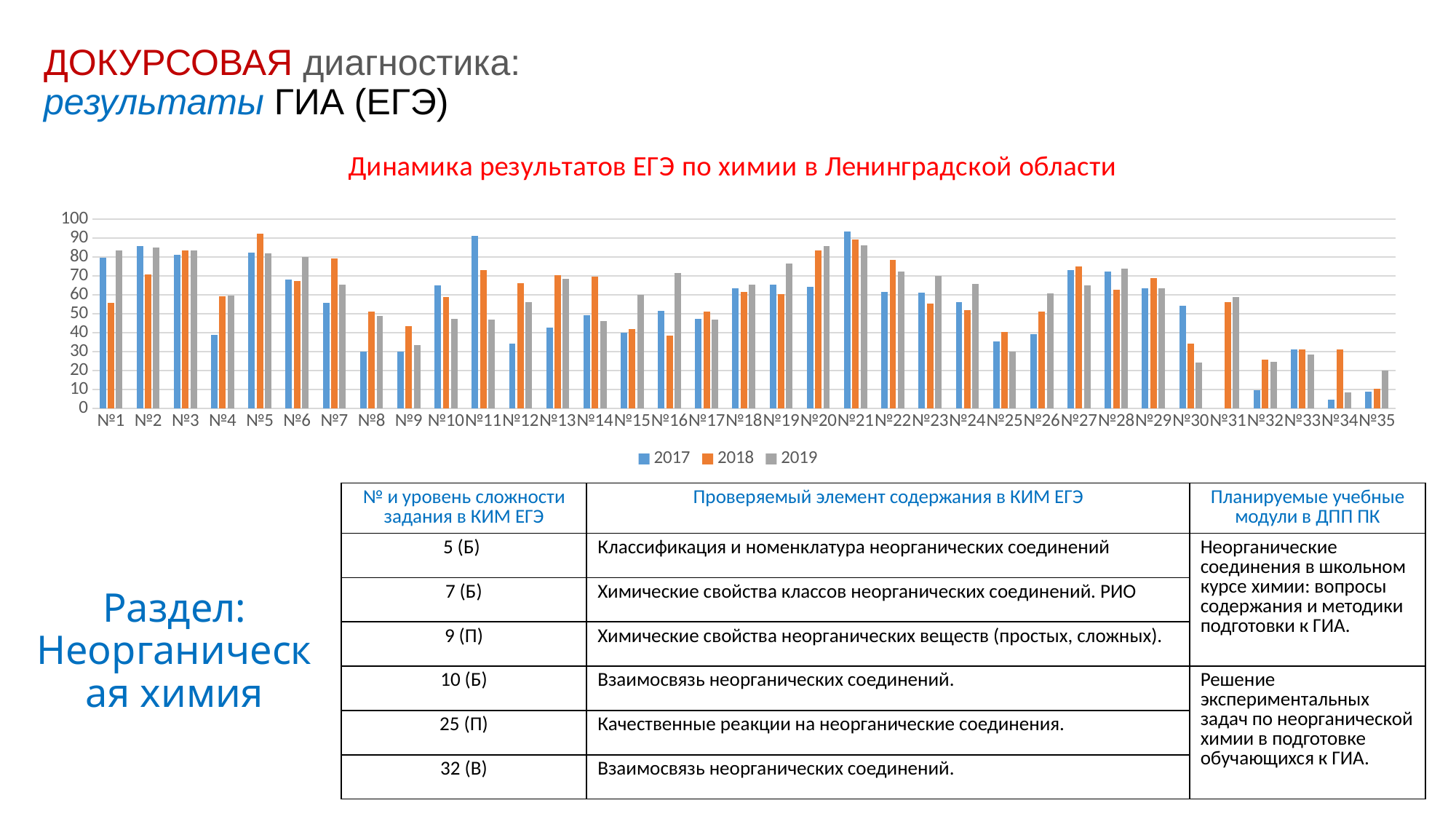
Is the 2018 value for №5 greater or less than 80? greater How many task categories (№1 to №35) are shown on the x axis? 35 Is the 2017 value for №8 greater or less than 40? less Which year is shown in orange in the legend? 2018 Is the 2019 value for №25 greater or less than 40? less How many series does the chart legend list? 3 For №15, which year has the larger value, 2017 or 2019? 2019 For №1, which year has the larger value, 2017 or 2018? 2017 What is the title of the chart? Динамика результатов ЕГЭ по химии в Ленинградской области What kind of chart is shown on the slide? bar chart